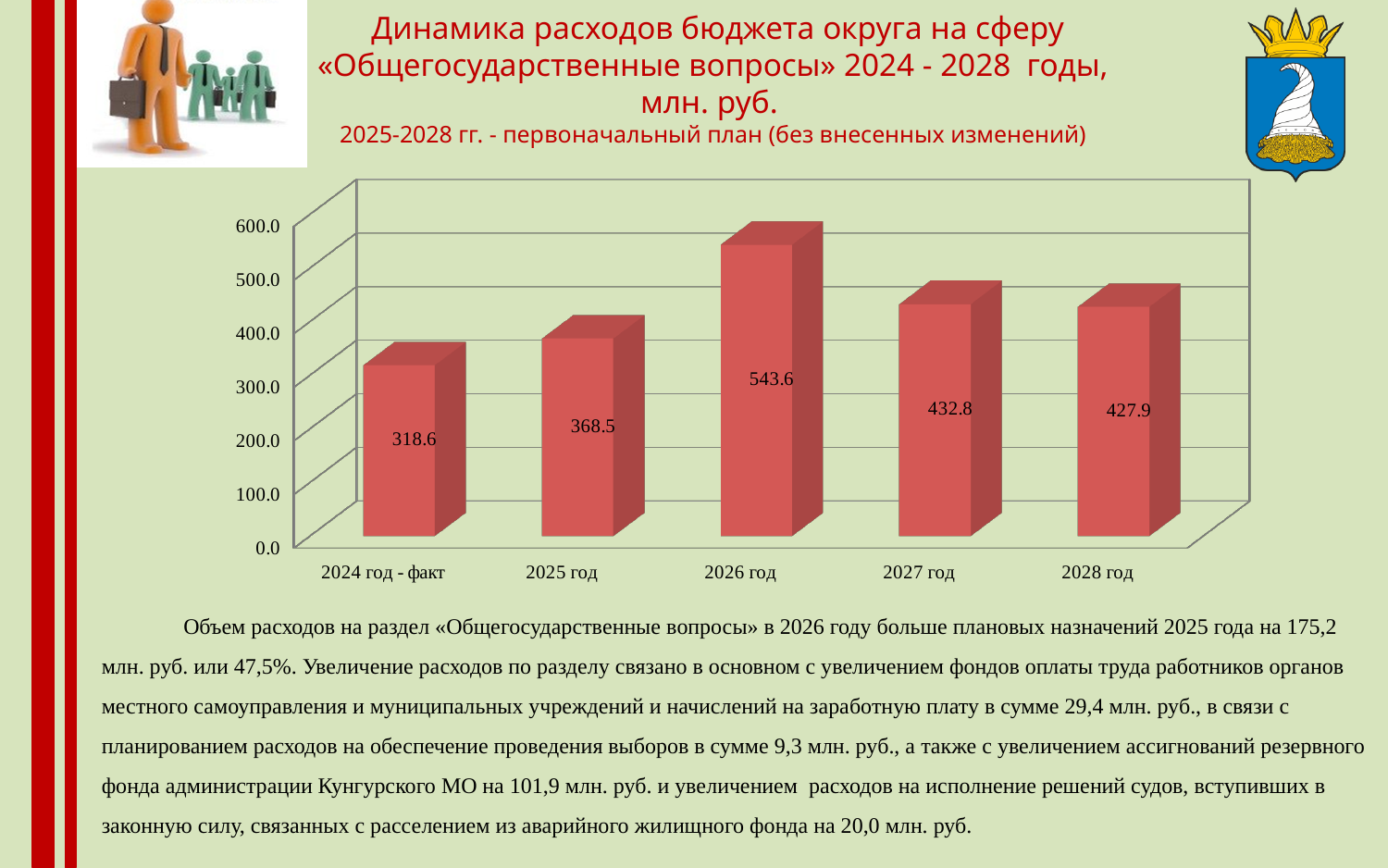
Which year has the highest value? 2026 год How many categories are shown on the x axis? 5 What is the difference between the values for 2026 год and 2025 год? 175.1 What is the value for 2026 год? 543.6 What is the value for 2028 год? 427.9 Which category has the lowest value? 2024 год - факт What kind of chart is shown on the slide? bar chart Do the values rise or fall from 2024 год - факт to 2026 год? rise Is the value for 2026 год greater or less than 500.0? greater Which is larger, the value for 2025 год or the value for 2027 год? 2027 год What is the difference between the values for 2027 год and 2028 год? 4.9 What is the value for 2024 год - факт? 318.6